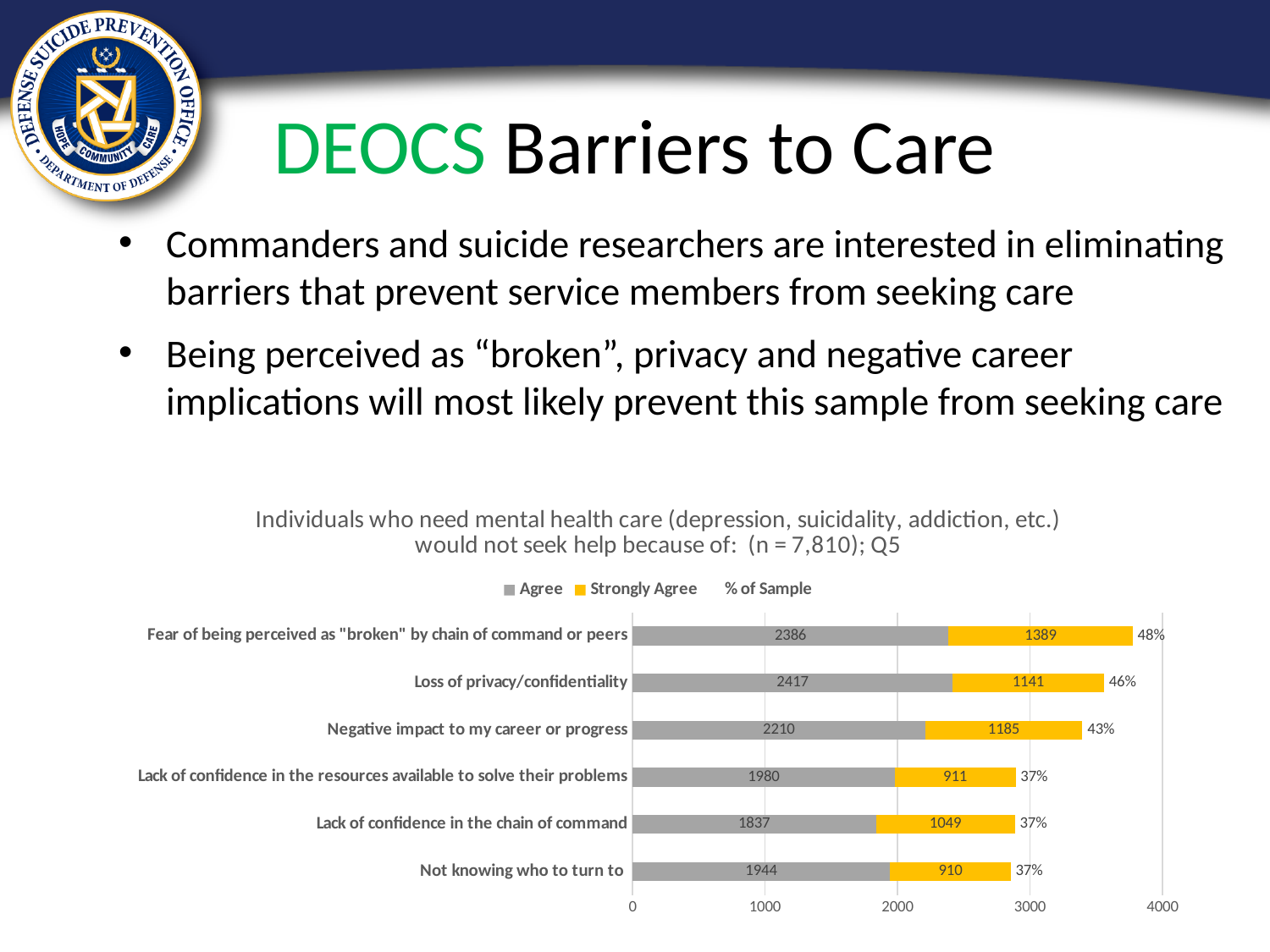
Which category has the highest Agree value? Loss of privacy/confidentiality What is the total of the Agree and Strongly Agree values for "Lack of confidence in the resources available to solve their problems"? 2891 Which category has the lowest Strongly Agree value? Not knowing who to turn to What is the Agree value for "Loss of privacy/confidentiality"? 2417 How many barrier categories are plotted in the chart? 6 What percentage of the sample is shown for "Negative impact to my career or progress"? 43% What is the sample size (n) stated in the chart title? 7,810 What is the Strongly Agree value for "Fear of being perceived as "broken" by chain of command or peers"? 1389 Is the total bar length for "Loss of privacy/confidentiality" greater or less than 3000? greater Which has a larger Agree value: "Lack of confidence in the chain of command" or "Not knowing who to turn to"? Not knowing who to turn to What is the difference between the Strongly Agree values for "Fear of being perceived as "broken" by chain of command or peers" and "Negative impact to my career or progress"? 204 What kind of chart is shown on the slide? Stacked bar chart